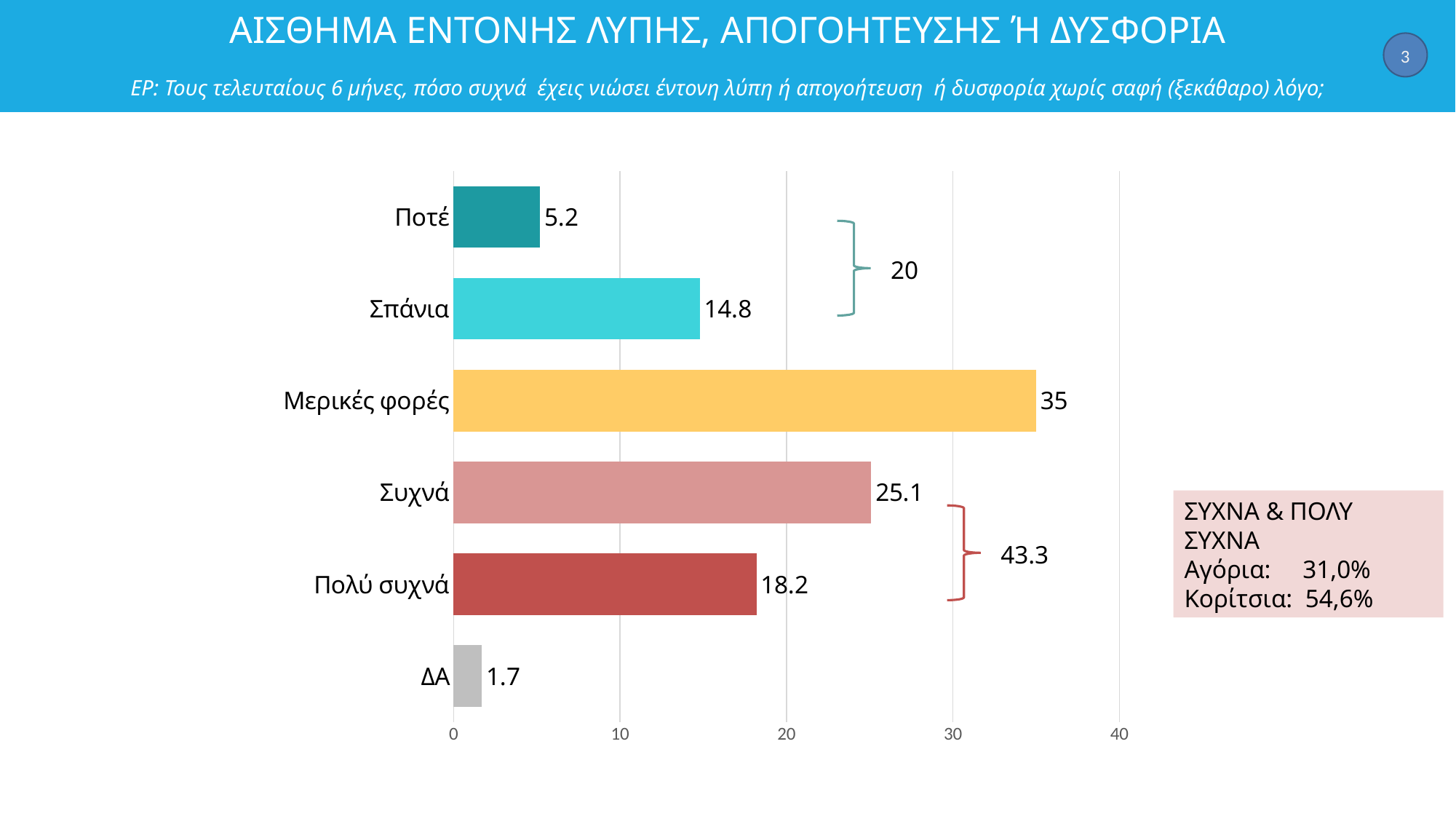
Which category has the lowest value? ΔΑ What is the value for Ποτέ? 5.2 What combined value is shown by the bracket grouping Συχνά and Πολύ συχνά? 43.3 Which is larger, the value for Σπάνια or the value for Πολύ συχνά? Πολύ συχνά What is the value for Μερικές φορές? 35 What kind of chart is shown on the slide? bar chart Which category has the highest value? Μερικές φορές What is the value for Πολύ συχνά? 18.2 What is the value for ΔΑ? 1.7 What is the difference between the values for Συχνά and Πολύ συχνά? 6.9 Is the value for Συχνά greater or less than 20? greater How many categories are shown in the chart? 6